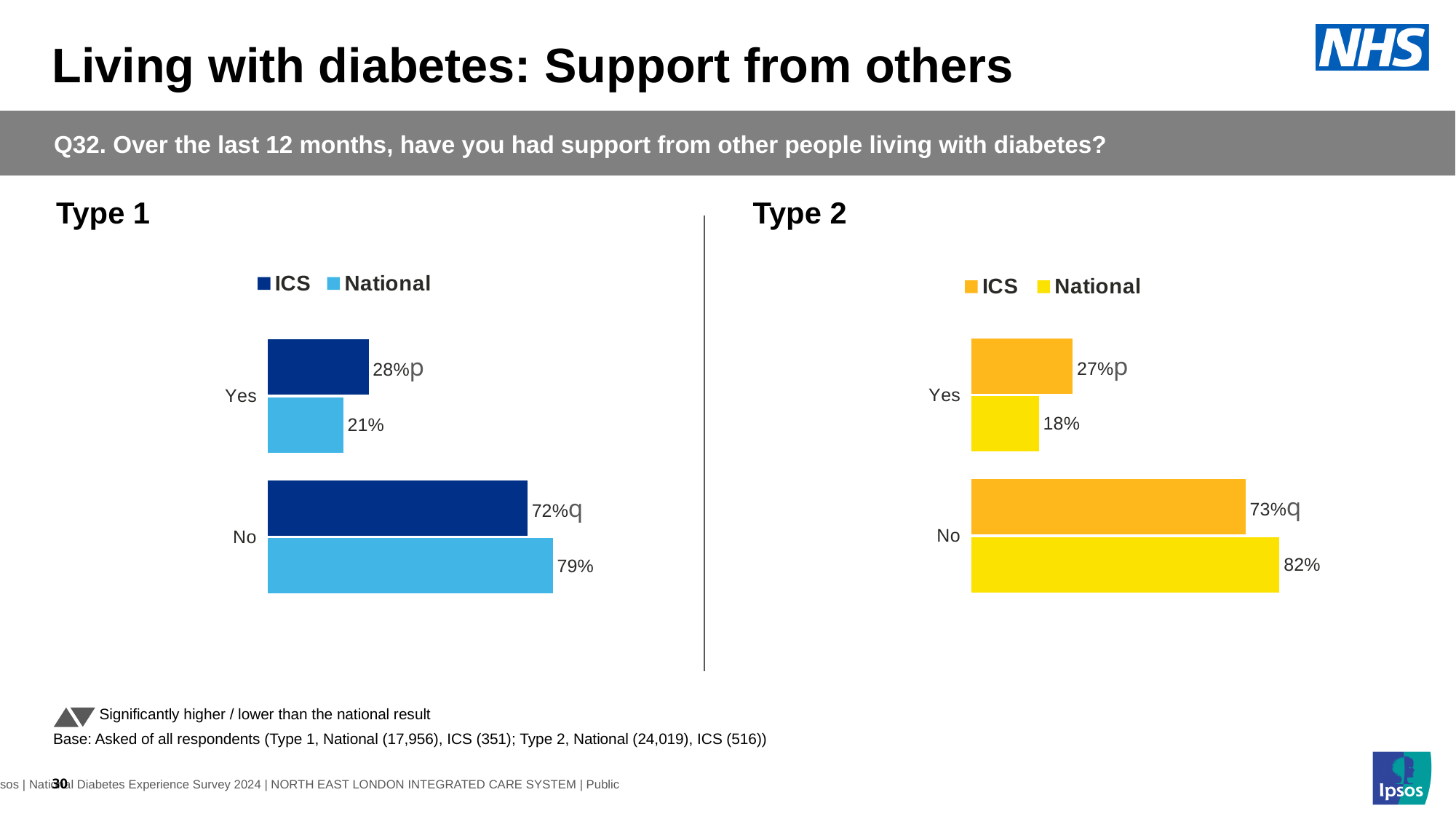
In the Type 2 chart, what colour are the National bars? Yellow In the Type 1 chart, which category has the highest National value? No In the Type 2 chart, what is the National value for Yes? 18% In the Type 2 chart, how many series does the legend list? 2 In the Type 2 chart, which is larger for Yes: ICS or National? ICS In the Type 2 chart, what is the ICS value for No? 73% In the Type 1 chart, what is the National value for No? 79% In the Type 1 chart, what is the ICS value for Yes? 28% What kind of chart is the Type 1 chart? Bar chart In the Type 1 chart, which is larger for No: ICS or National? National In the Type 1 chart, what is the difference between the ICS and National values for Yes? 7 percentage points In the Type 2 chart, what is the difference between the National and ICS values for No? 9 percentage points